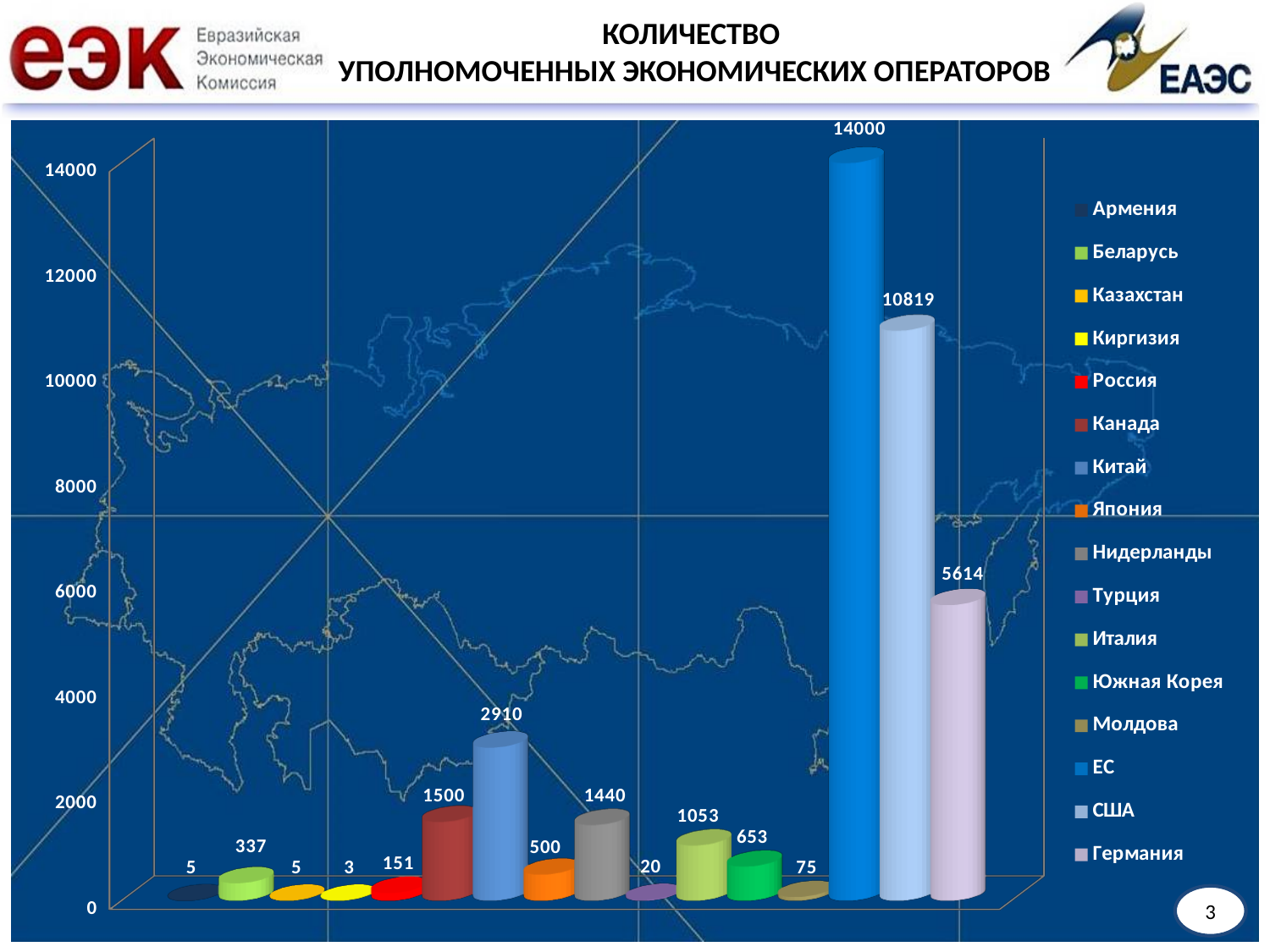
What kind of chart is shown on the slide? Bar chart Which is larger, the value for Канада or the value for Нидерланды? Канада Which category has the lowest value? Киргизия What is the value for ЕС? 14000 What is the difference between the values for ЕС and США? 3181 What is the value for США? 10819 How many categories does the legend list? 16 What is the title of the slide? КОЛИЧЕСТВО УПОЛНОМОЧЕННЫХ ЭКОНОМИЧЕСКИХ ОПЕРАТОРОВ What is the value for Германия? 5614 Which category has the highest value? ЕС What is the value for Китай? 2910 What is the value for Беларусь? 337